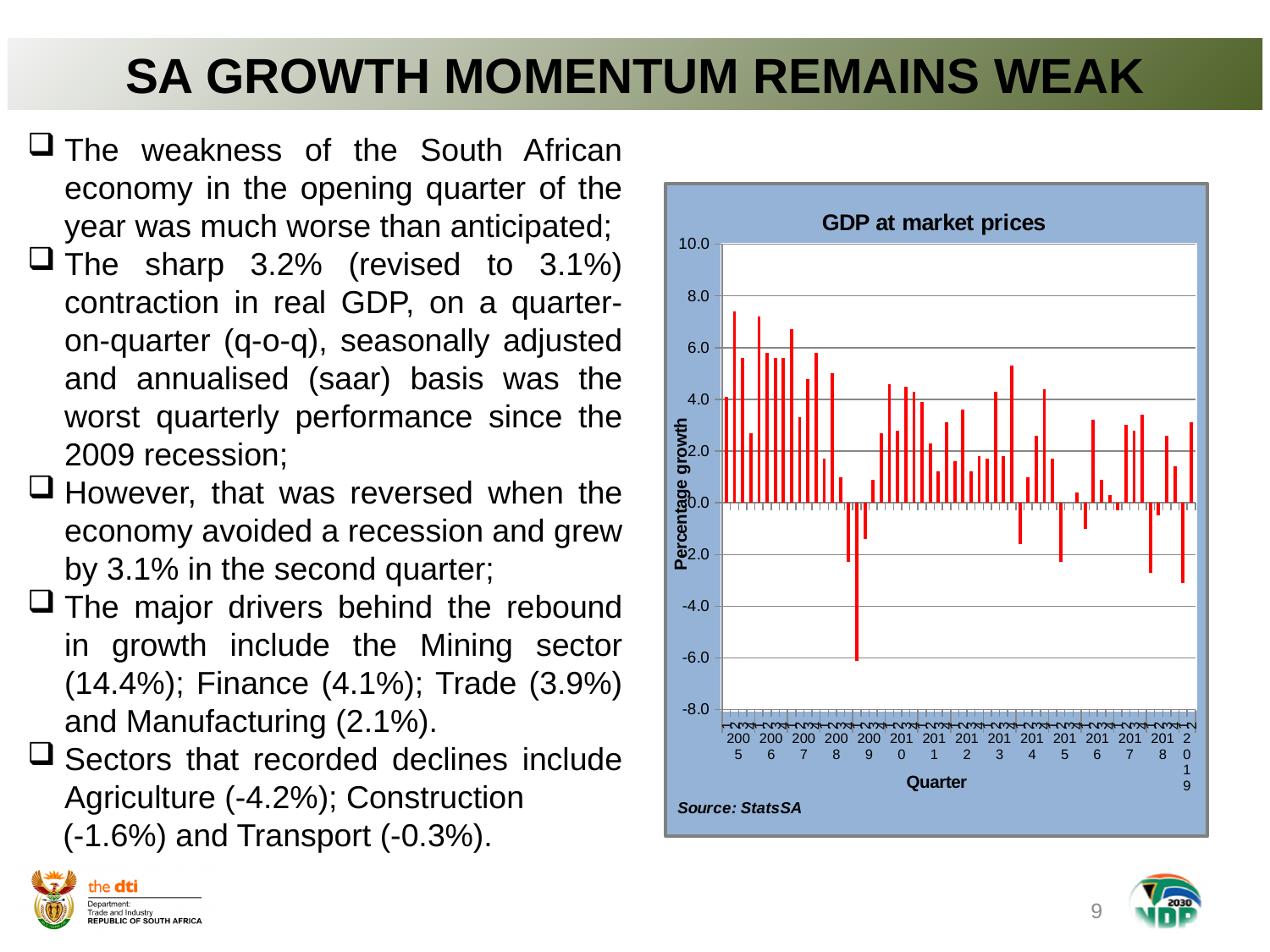
What is the last year labelled on the horizontal axis of the chart? 2019 Is the tallest bar in the chart greater or less than 6.0? greater Is the final bar in the chart (second quarter of 2019) greater or less than 0.0? greater What kind of chart is shown on the slide? Bar chart What is the label of the vertical axis of the chart? Percentage growth What is the highest value shown on the vertical axis of the chart? 10.0 Is the lowest bar in the chart (in 2009) greater or less than -4.0? less What is the title of the chart? GDP at market prices What is the first year labelled on the horizontal axis of the chart? 2005 How many years are labelled along the horizontal axis of the chart? 15 What is the lowest value shown on the vertical axis of the chart? -8.0 In which year does the chart show its lowest (most negative) quarterly bar? 2009